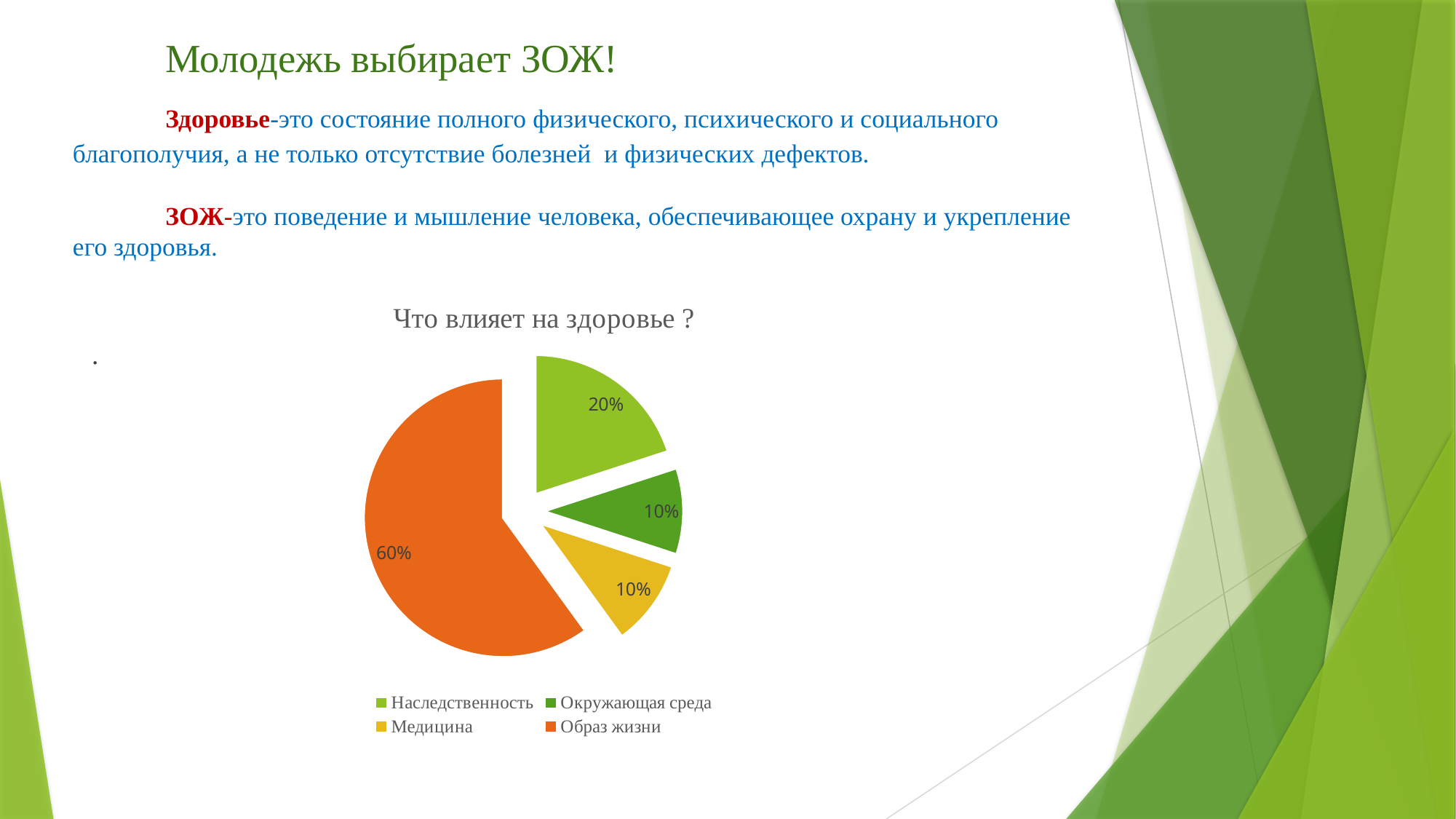
What is the difference between the shares of Образ жизни and Наследственность? 40% What colour is the slice for Образ жизни? orange What share of the pie does Медицина have? 10% How many entries does the legend list? 4 What share of the pie does Окружающая среда have? 10% Which is larger, the share for Наследственность or the share for Медицина? Наследственность What share of the pie does Наследственность have? 20% What type of chart is shown on the slide? pie chart What is the title of the chart? Что влияет на здоровье ? Which category has the largest slice of the pie? Образ жизни What share of the pie does Образ жизни have? 60% How many slices does the pie chart have? 4